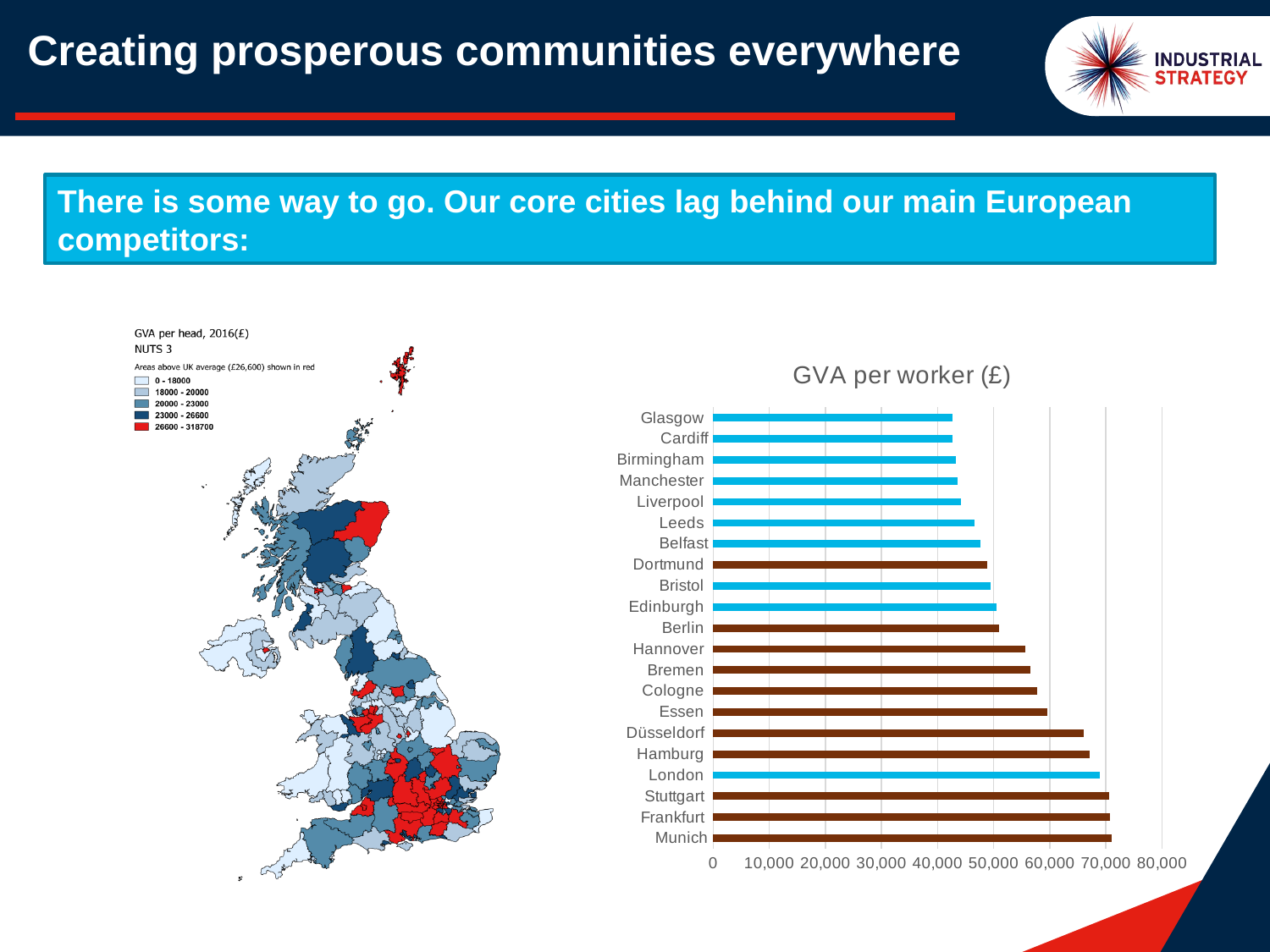
What is the title of the bar chart on the right of the slide? GVA per worker (£) On the 'GVA per worker (£)' chart, is the value for London greater or less than 60,000? greater On the 'GVA per worker (£)' chart, is the value for Hamburg greater or less than 60,000? greater On the 'GVA per worker (£)' chart, is the value for Leeds greater or less than 50,000? less On the 'GVA per worker (£)' chart, which has the higher GVA per worker, London or Glasgow? London On the 'GVA per worker (£)' chart, which has the higher GVA per worker, Hamburg or Berlin? Hamburg How many cities are shown on the 'GVA per worker (£)' chart? 21 On the 'GVA per worker (£)' chart, do the bars get longer or shorter going from Glasgow at the top down to Munich at the bottom? longer On the 'GVA per worker (£)' chart, which has the higher GVA per worker, Düsseldorf or Essen? Düsseldorf What type of chart is the 'GVA per worker (£)' chart? bar chart